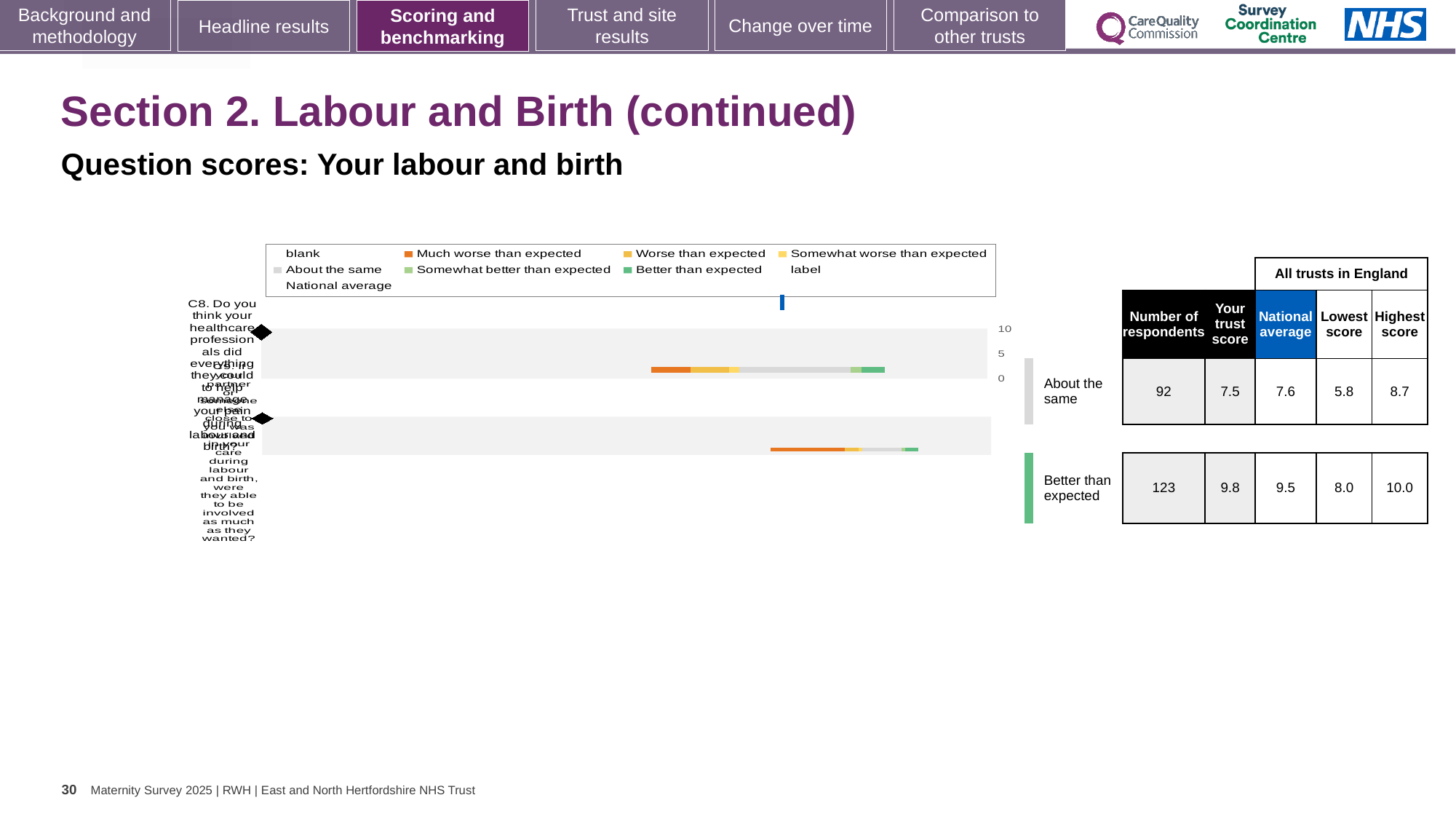
Which row has the higher 'Your trust score': 'About the same' or 'Better than expected'? Better than expected What is the Highest score across all trusts in England for the row rated 'Better than expected'? 10.0 How many respondents are listed for the row rated 'About the same'? 92 How many question rows are plotted in the chart? 2 What is the Lowest score across all trusts in England for the row rated 'About the same'? 5.8 What kind of chart is shown on the slide? Bar chart For the row rated 'About the same', which is larger: the trust score or the National average? National average What is the 'Your trust score' for the row rated 'About the same'? 7.5 How many respondents are listed for the row rated 'Better than expected'? 123 What colour does the legend use for 'Much worse than expected'? Orange What is the National average for the row rated 'Better than expected'? 9.5 By how much does the trust score exceed the National average for the row rated 'Better than expected'? 0.3